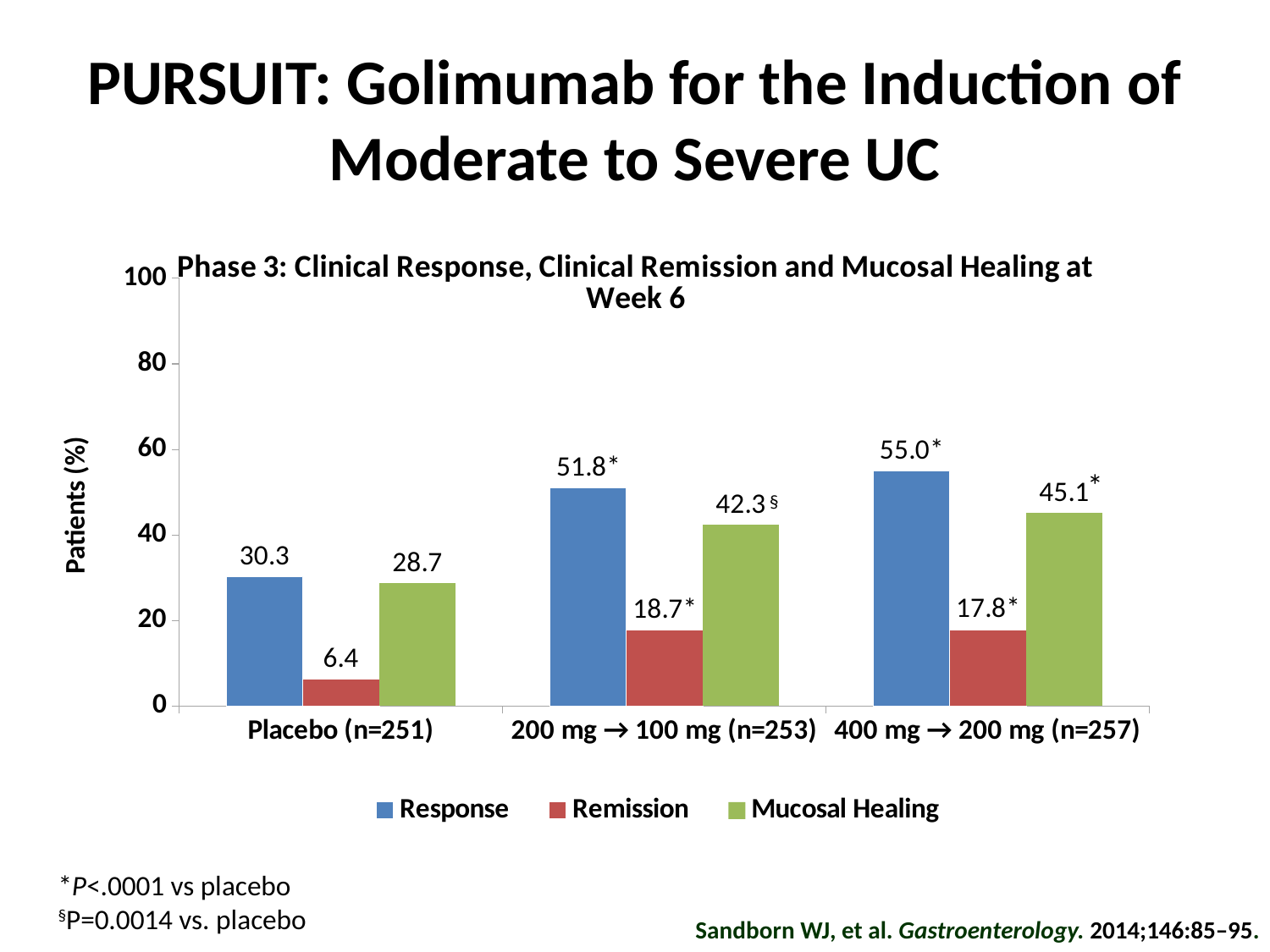
What is the Mucosal Healing value for the 400 mg → 200 mg (n=257) group? 45.1 Which group has the highest Response value? 400 mg → 200 mg (n=257) What is the Remission value for the 200 mg → 100 mg (n=253) group? 18.7 What is the difference between the Response values for the 400 mg → 200 mg (n=257) group and the Placebo (n=251) group? 24.7 How many groups are shown on the x axis? 3 How many series does the legend list? 3 Is the Remission value for the Placebo (n=251) group greater or less than 20? less What is the label of the y axis? Patients (%) Which group has the lowest Remission value? Placebo (n=251) What is the Response value for the Placebo (n=251) group? 30.3 Which is larger: the Mucosal Healing value for 200 mg → 100 mg (n=253) or for Placebo (n=251)? 200 mg → 100 mg (n=253) What kind of chart is shown on the slide? bar chart